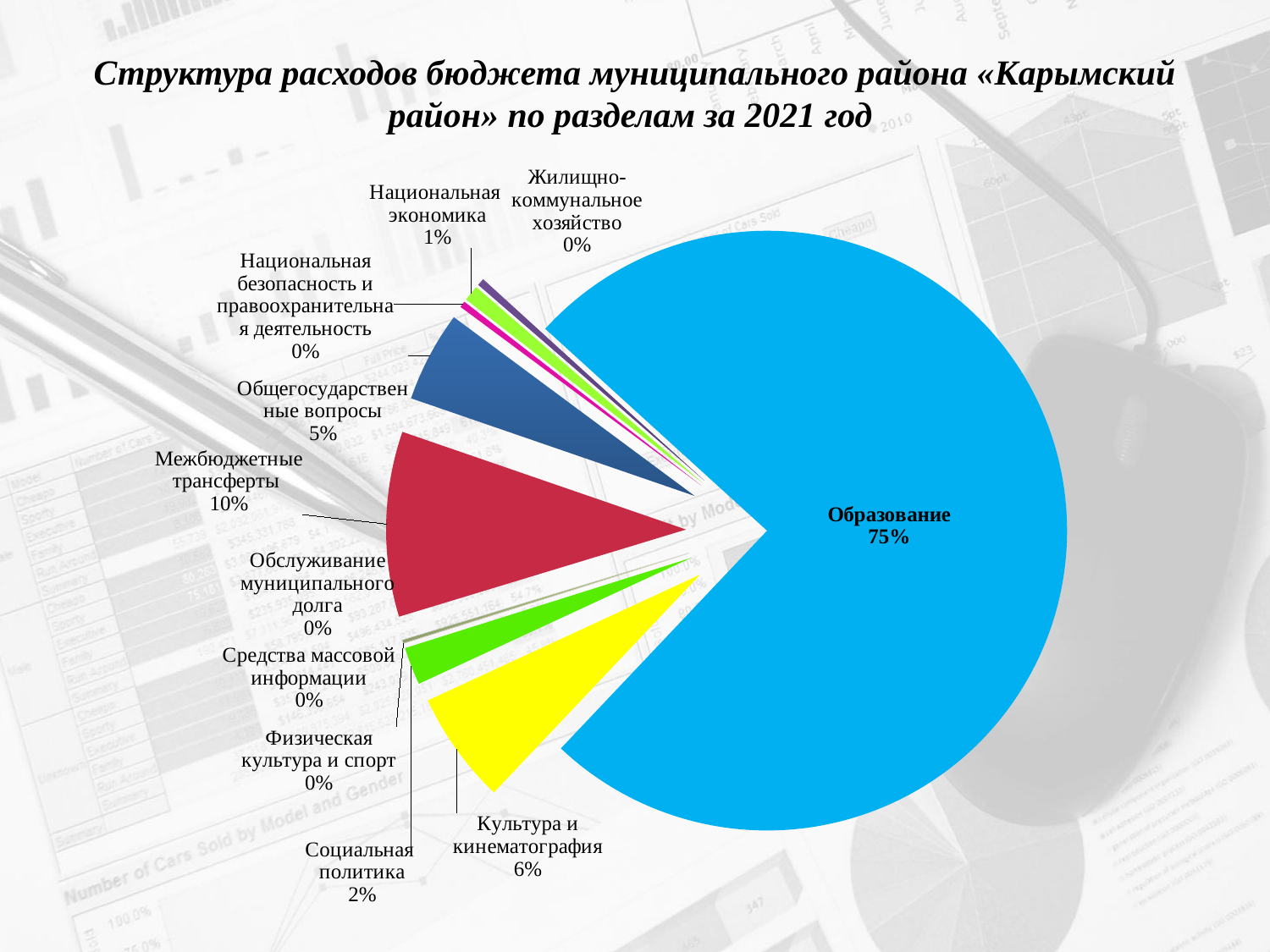
What is the difference between the shares of Образование and Межбюджетные трансферты? 65% What share of expenditures goes to Межбюджетные трансферты? 10% For which year does the chart show the budget expenditure structure? 2021 What share of expenditures goes to Образование? 75% How many sections (categories) are labelled on the pie chart? 11 What is the value shown for Национальная экономика? 1% Which section has the largest share of budget expenditures? Образование Which is larger: the share for Культура и кинематография or for Общегосударственные вопросы? Культура и кинематография What kind of chart is shown on the slide? pie chart What is the value shown for Социальная политика? 2% What is the value shown for Общегосударственные вопросы? 5% What is the value shown for Культура и кинематография? 6%